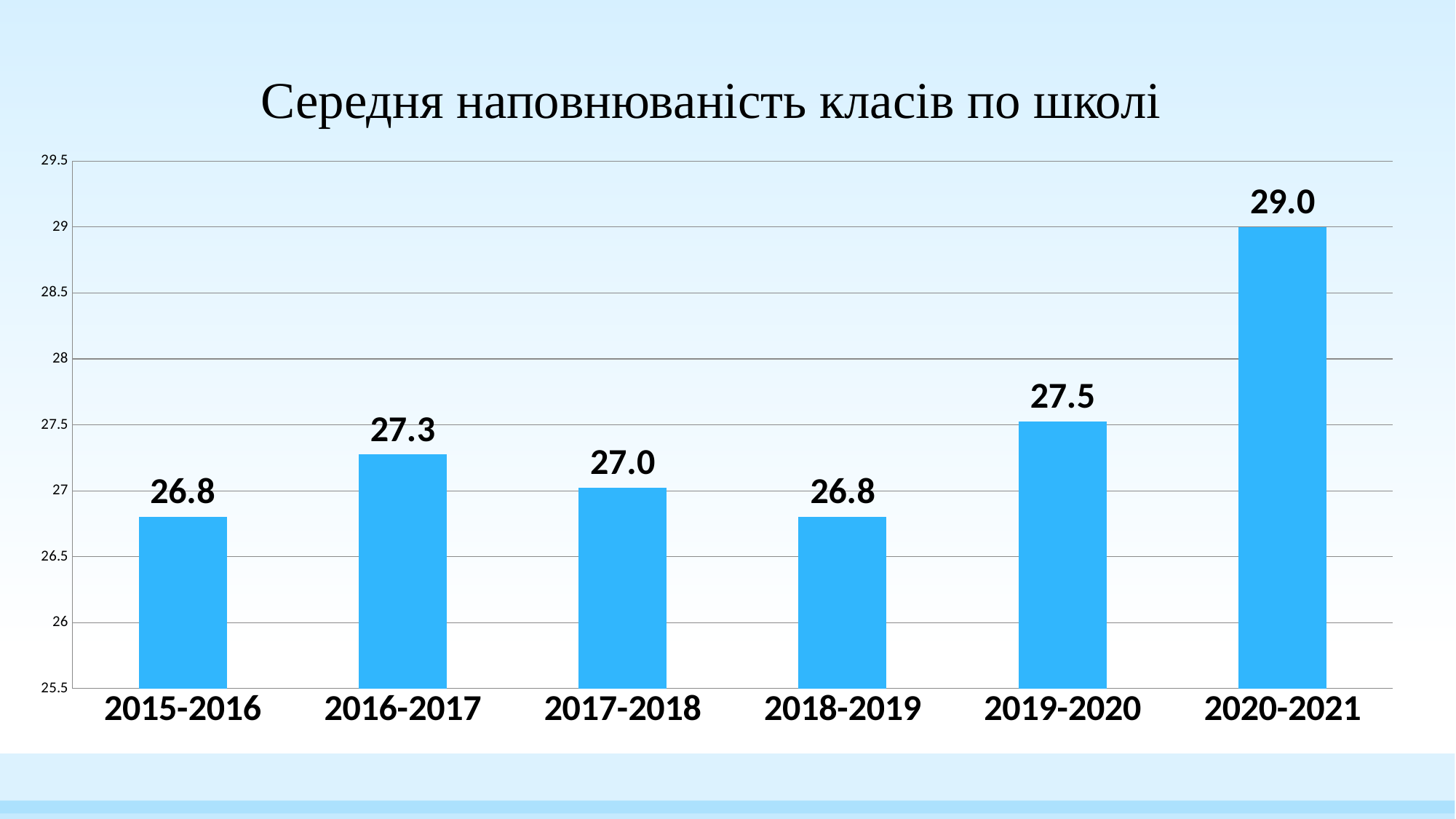
What is the value for 2017-2018? 27.0 Which year has the highest value? 2020-2021 What is the difference between the values for 2020-2021 and 2019-2020? 1.5 Which is larger, the value for 2016-2017 or the value for 2017-2018? 2016-2017 What is the value for 2016-2017? 27.3 What kind of chart is this? bar chart What is the difference between the values for 2016-2017 and 2015-2016? 0.5 What is the value for 2020-2021? 29.0 Is the value for 2020-2021 greater or less than 28? greater What is the title of the chart? Середня наповнюваність класів по школі How many years are shown on the chart? 6 What is the value for 2019-2020? 27.5